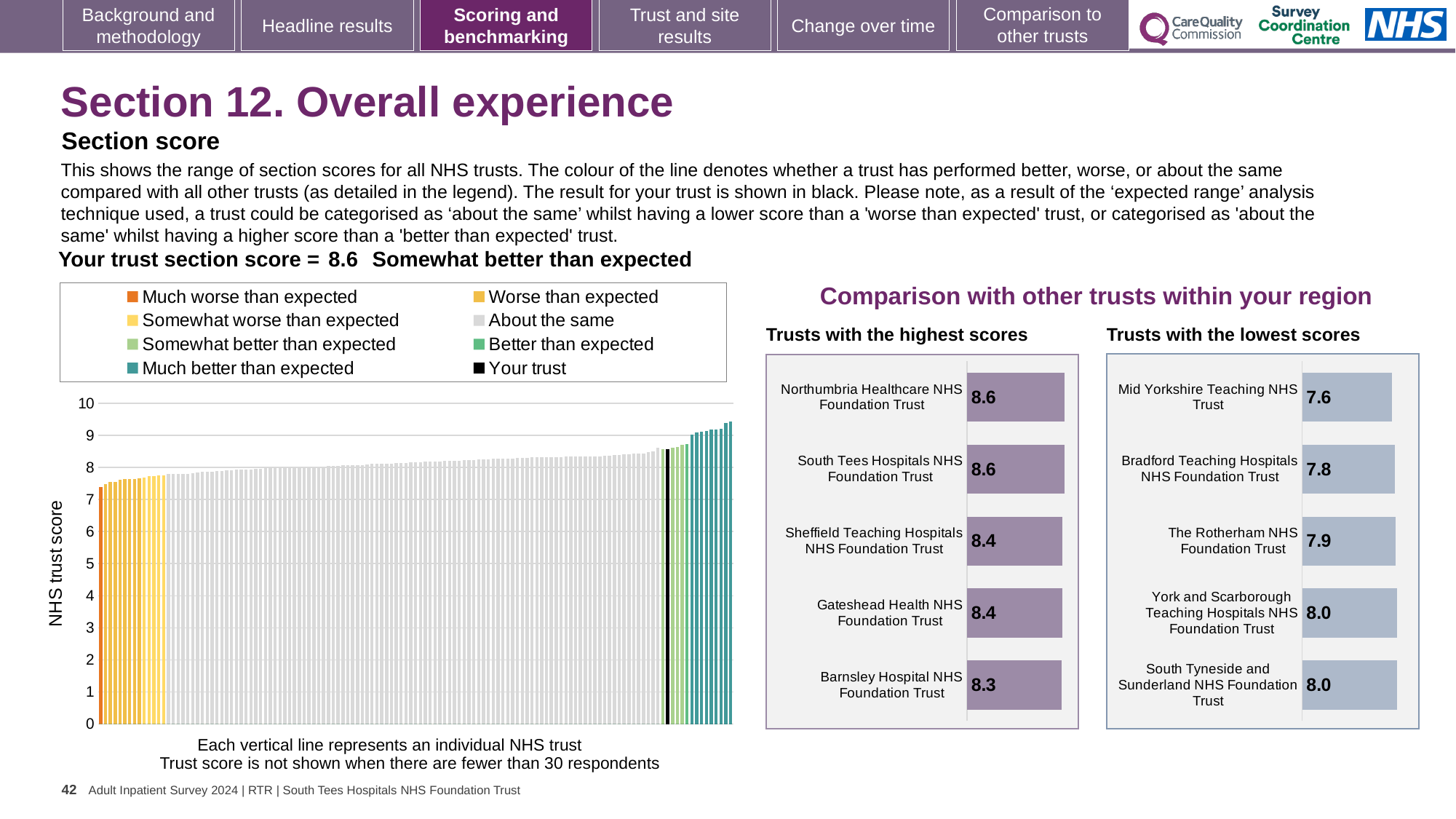
In the 'Trusts with the lowest scores' chart, how much higher is The Rotherham NHS Foundation Trust's score than Mid Yorkshire Teaching NHS Trust's score? 0.3 What kind of chart is the NHS trust score chart on the left of the slide? Bar chart In the 'Trusts with the lowest scores' chart, what is the score for Mid Yorkshire Teaching NHS Trust? 7.6 In the 'Trusts with the lowest scores' chart, which has the higher score: Bradford Teaching Hospitals NHS Foundation Trust or The Rotherham NHS Foundation Trust? The Rotherham NHS Foundation Trust How many trusts are listed in the 'Trusts with the highest scores' chart? 5 How many entries does the legend of the NHS trust score chart on the left list? 8 In the 'Trusts with the highest scores' chart, what is the difference between the scores of Northumbria Healthcare NHS Foundation Trust and Barnsley Hospital NHS Foundation Trust? 0.3 In the 'Trusts with the highest scores' chart, which trust has the lowest score shown? Barnsley Hospital NHS Foundation Trust In the 'Trusts with the highest scores' chart, what is the score for Sheffield Teaching Hospitals NHS Foundation Trust? 8.4 In the 'Trusts with the lowest scores' chart, which trust has the lowest score? Mid Yorkshire Teaching NHS Trust In the NHS trust score chart on the left, is the value of the leftmost (orange) bar greater or less than 8? less In the NHS trust score chart on the left, do the bar values rise or fall from left to right? Rise